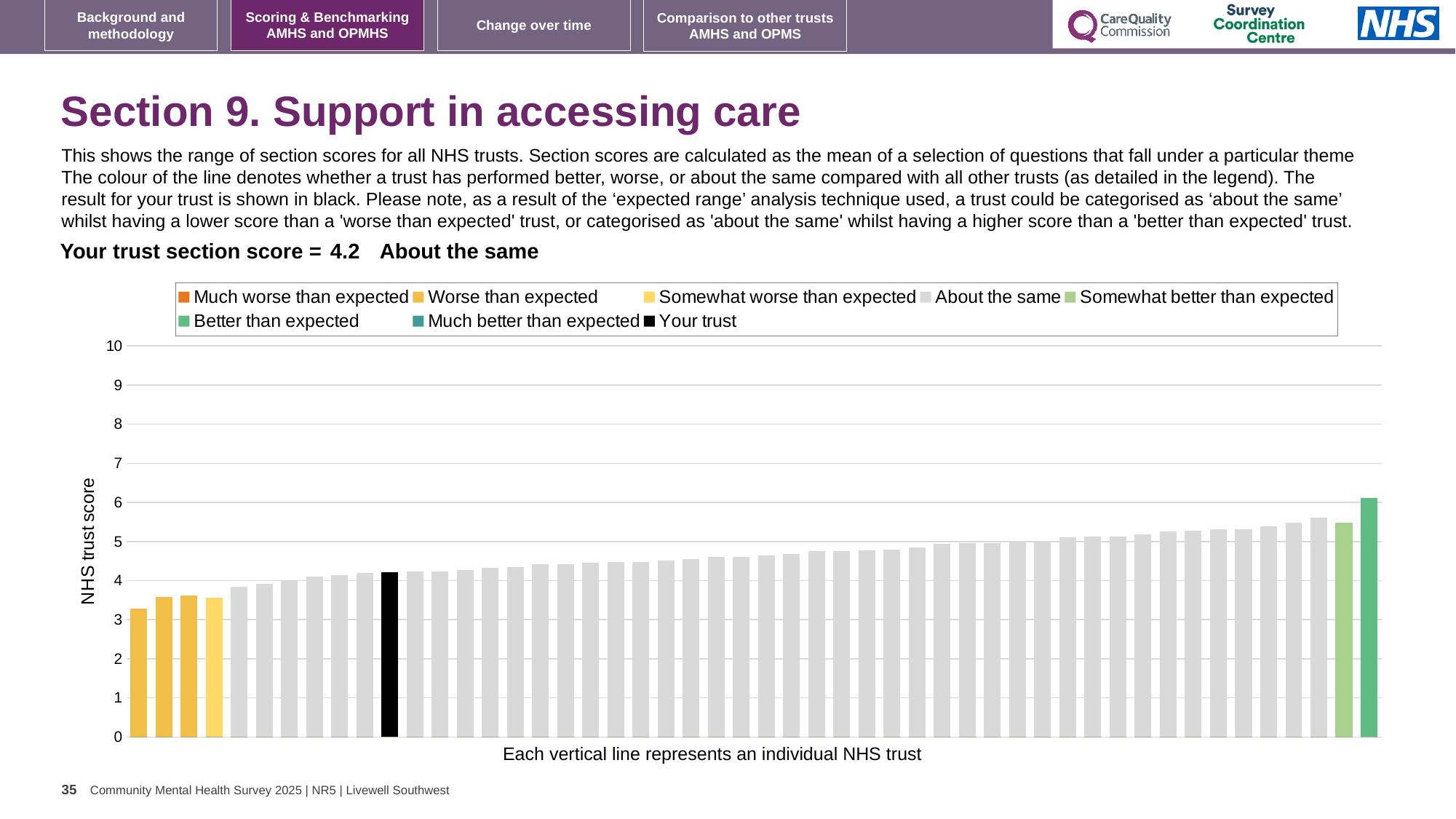
Is the value for your trust greater or less than 4? greater What kind of chart is shown on the slide? Bar chart Is the value of the lowest bar greater or less than 3? greater How many bars in the chart are coloured green? 2 Is the value of the highest bar greater or less than 5? greater What is the label on the y axis of the chart? NHS trust score How is your trust's section score categorised compared with other trusts? About the same Do the bar values rise or fall from left to right along the x axis? Rise How many entries does the chart legend list? 8 What is the section score for your trust shown on the slide? 4.2